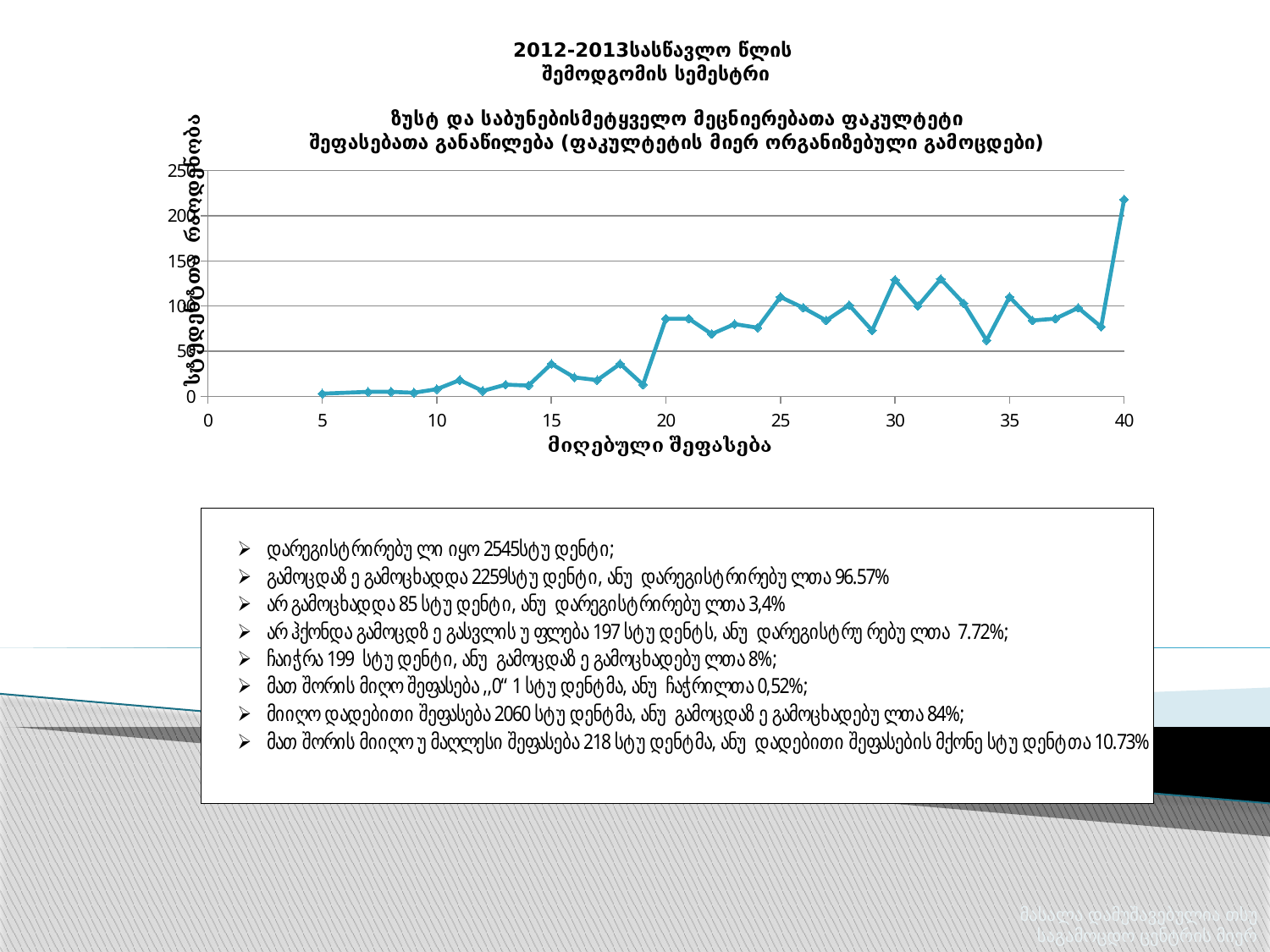
Overall, do the values rise or fall as the received score increases along the x axis? rise Is the number of students at score 34 greater or less than 100? less Is the number of students at score 19 greater or less than 50? less Is the number of students at score 30 greater or less than 100? greater Which has more students: score 32 or score 34? score 32 Which has more students: score 19 or score 20? score 20 What kind of chart is shown on the slide? line chart At which received score (x-axis value) is the number of students highest? 40 What is the title of the x axis of the chart? მიღებული შეფასება How many data series are plotted on the chart? 1